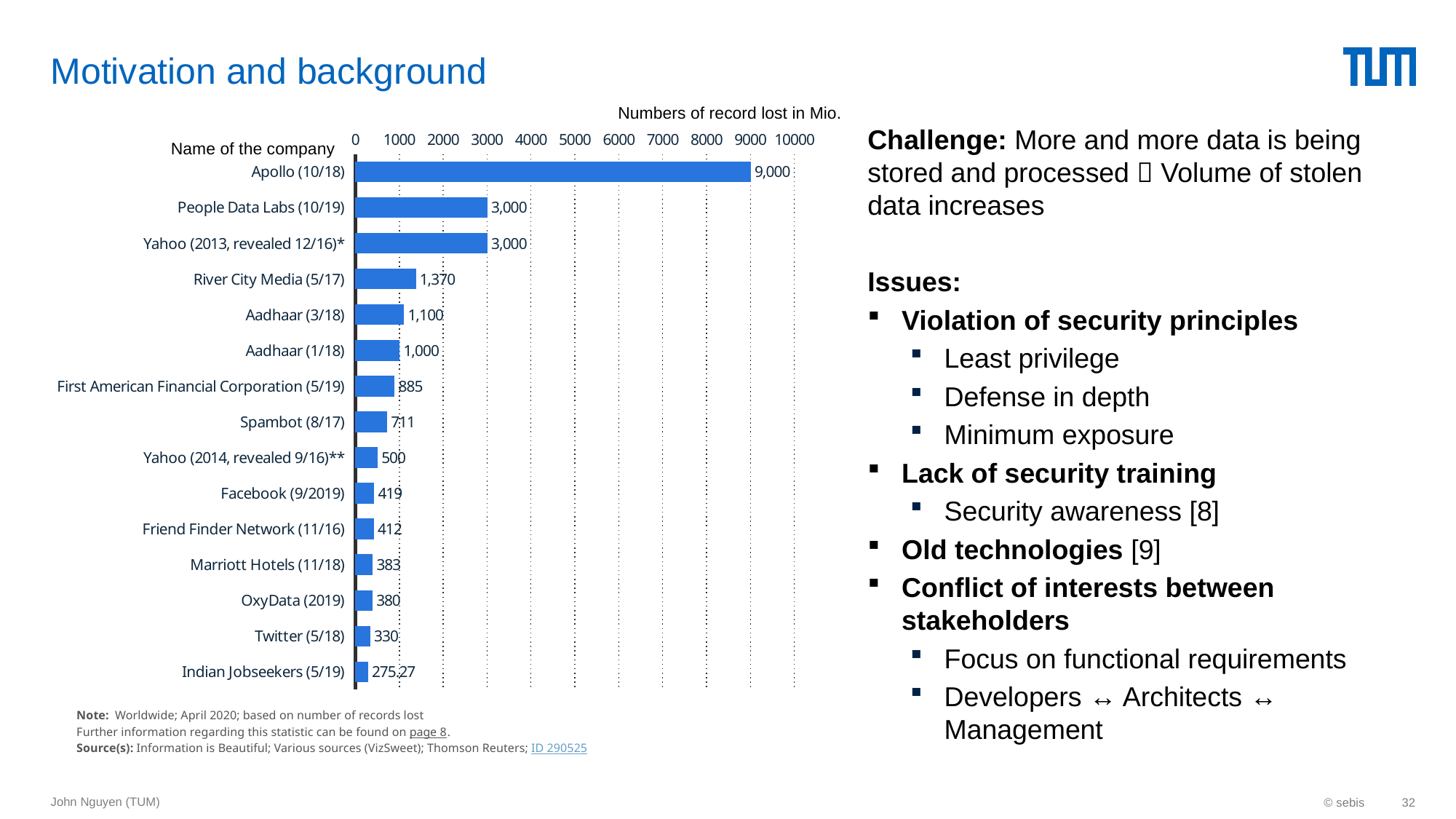
What is the number of records lost (in Mio.) for River City Media (5/17)? 1,370 What type of chart is shown on the slide? Bar chart What is the number of records lost (in Mio.) for Indian Jobseekers (5/19)? 275.27 Which company has the lowest number of records lost? Indian Jobseekers (5/19) What is the number of records lost (in Mio.) for Apollo (10/18)? 9,000 Which company has the highest number of records lost? Apollo (10/18) What is the label of the value axis of the chart? Numbers of record lost in Mio. How many companies are shown in the chart? 15 What is the difference in records lost between Apollo (10/18) and People Data Labs (10/19)? 6,000 Which has more records lost: Aadhaar (3/18) or Aadhaar (1/18)? Aadhaar (3/18) What is the number of records lost (in Mio.) for Marriott Hotels (11/18)? 383 Is the value for First American Financial Corporation (5/19) greater or less than 1000? less